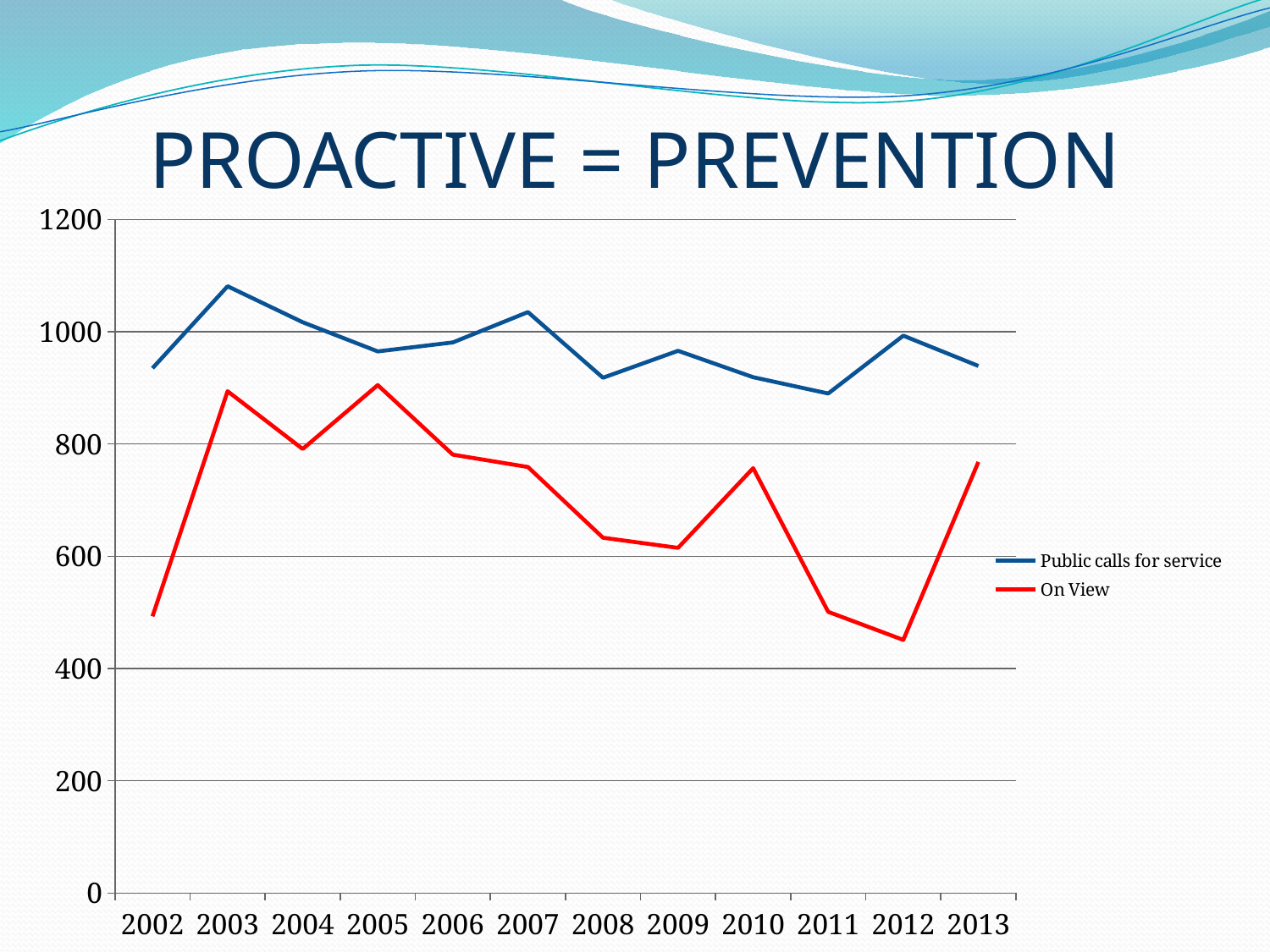
What is the title of the slide containing the chart? PROACTIVE = PREVENTION In which year is the Public calls for service series at its highest? 2003 In which year is the On View series at its lowest? 2012 Does the On View series rise or fall from 2010 to 2012? fall In 2002, which series has the larger value, Public calls for service or On View? Public calls for service Which series is drawn in red? On View Is the On View value for 2013 greater or less than 600? greater Is the On View value for 2002 greater or less than 600? less Is the Public calls for service value for 2003 greater or less than 1000? greater How many years are plotted along the x axis? 12 What kind of chart is shown on the slide? line chart How many series does the legend list? 2